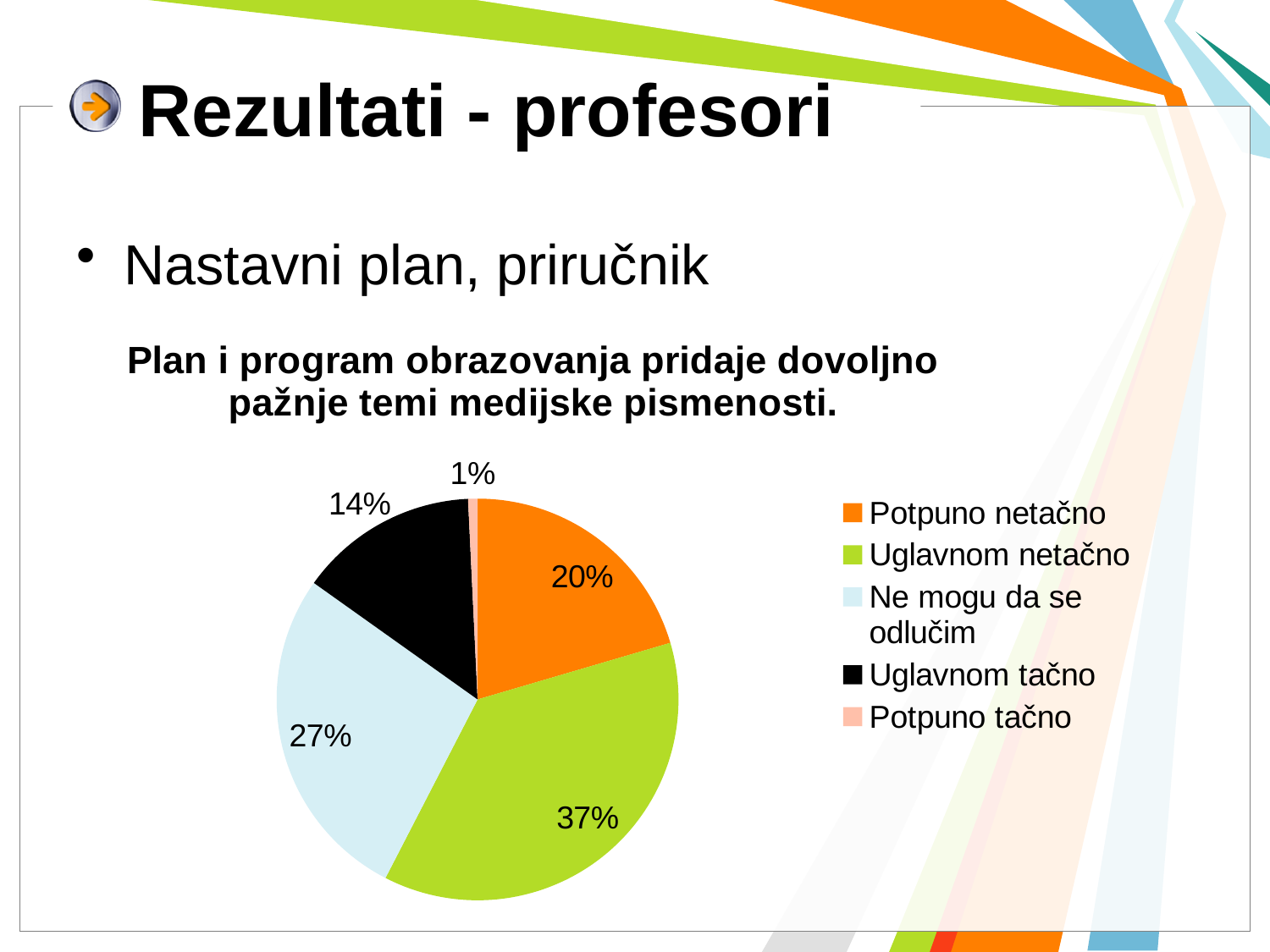
What percentage of the pie is labelled "Uglavnom tačno"? 14% Which is larger, the share for "Potpuno netačno" or the share for "Uglavnom tačno"? Potpuno netačno What is the title of the chart? Plan i program obrazovanja pridaje dovoljno pažnje temi medijske pismenosti. Which category has the smallest share of the pie? Potpuno tačno Which category has the largest share of the pie? Uglavnom netačno What percentage of the pie is labelled "Potpuno tačno"? 1% What percentage of the pie is labelled "Uglavnom netačno"? 37% What percentage of the pie is labelled "Ne mogu da se odlučim"? 27% What kind of chart is shown on the slide? pie chart What percentage of the pie is labelled "Potpuno netačno"? 20% What is the difference in percentage points between "Uglavnom netačno" and "Ne mogu da se odlučim"? 10 How many categories does the legend list? 5